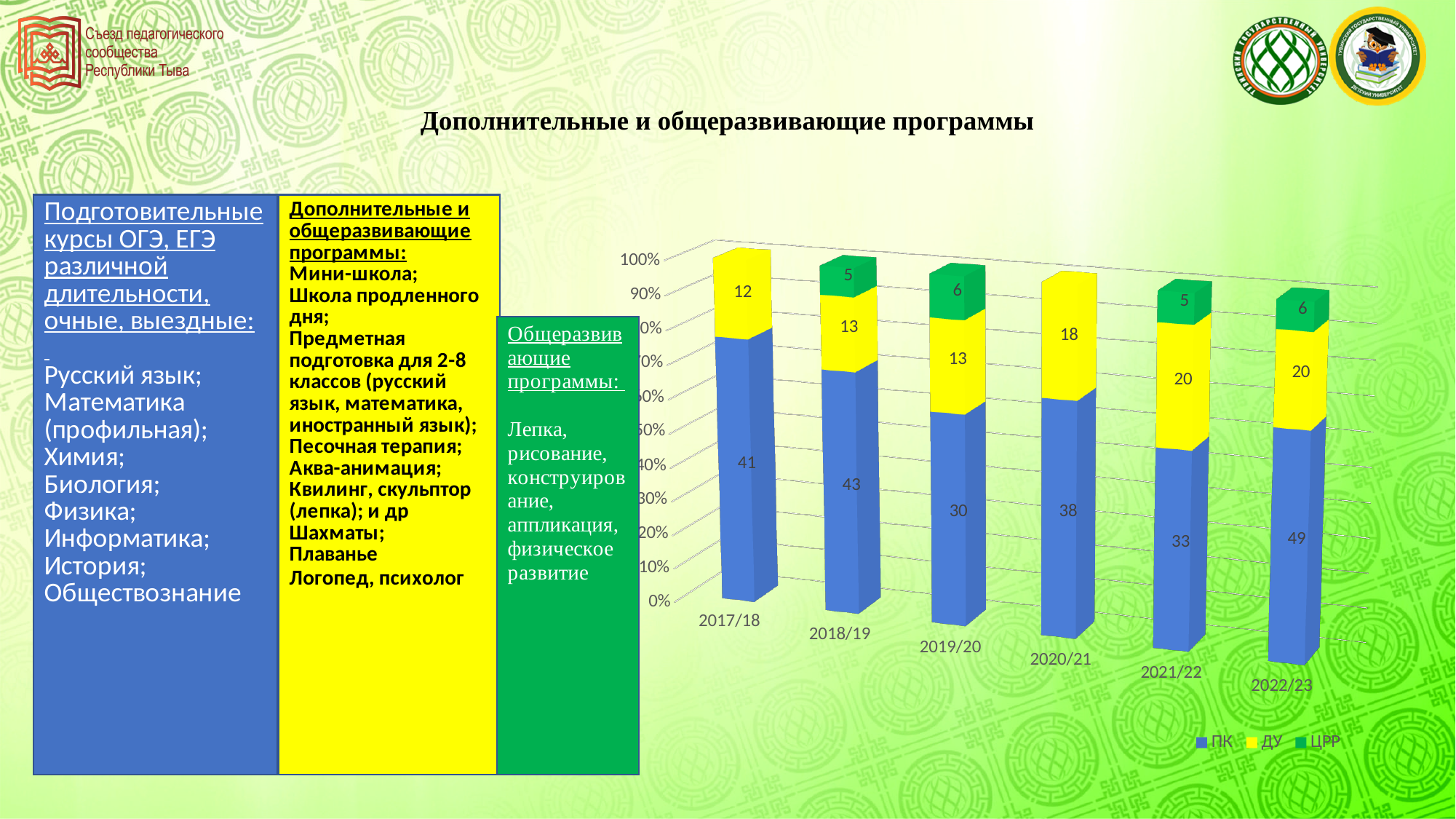
What is the total of the labelled values in the 2018/19 bar? 61 What is the value of ЦРР for 2019/20? 6 How many series does the legend list? 3 Which is larger, the ДУ value for 2017/18 or for 2021/22? 2021/22 Which series is shown in yellow? ДУ What is the value of ПК for 2022/23? 49 What kind of chart is shown? Stacked bar chart In which year is the ПК value the lowest? 2019/20 What is the value of ДУ for 2020/21? 18 In which year is the ПК value the highest? 2022/23 How many years are shown on the x axis? 6 What is the difference between the ПК values for 2022/23 and 2021/22? 16